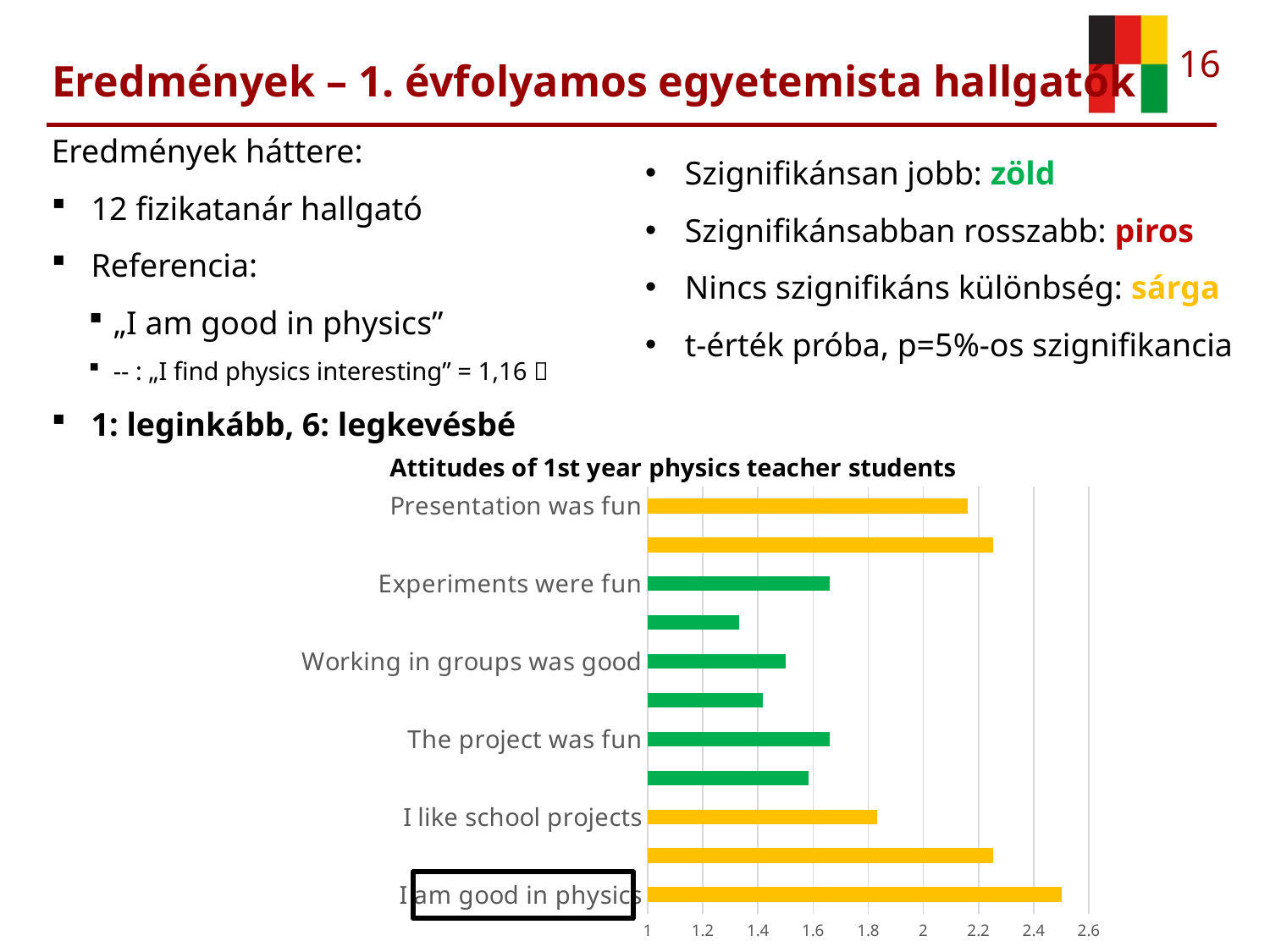
What colour is the bar for "Experiments were fun"? green How many category labels are shown on the vertical axis of the chart? 6 Is the value for "I like school projects" greater or less than 1.6? greater Is the value for "Experiments were fun" greater or less than 1.8? less Is the value for "I am good in physics" greater or less than 2.4? greater Which labelled category has the longest bar in the chart? I am good in physics Which has the larger value, "Presentation was fun" or "Experiments were fun"? Presentation was fun What kind of chart is shown on the slide? bar chart What is the title of the chart? Attitudes of 1st year physics teacher students Which has the larger value, "I am good in physics" or "I like school projects"? I am good in physics